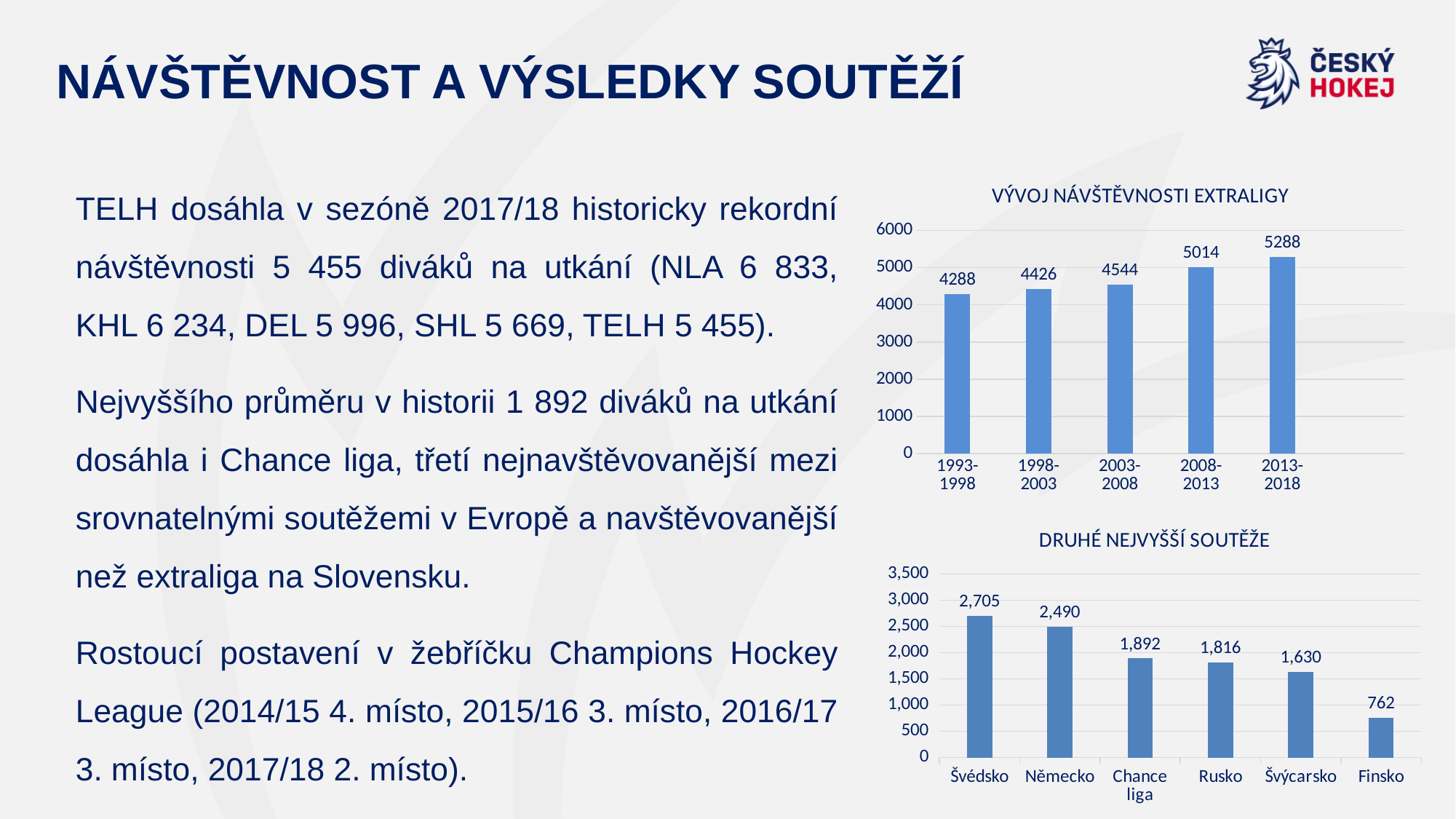
How many periods are shown in the 'VÝVOJ NÁVŠTĚVNOSTI EXTRALIGY' chart? 5 How many categories are shown in the 'DRUHÉ NEJVYŠŠÍ SOUTĚŽE' chart? 6 In the 'VÝVOJ NÁVŠTĚVNOSTI EXTRALIGY' chart, which period has the highest value? 2013-2018 In the 'DRUHÉ NEJVYŠŠÍ SOUTĚŽE' chart, which is larger, Švédsko or Německo? Švédsko In the 'DRUHÉ NEJVYŠŠÍ SOUTĚŽE' chart, what is the difference between the values for Švédsko and Finsko? 1,943 In the 'VÝVOJ NÁVŠTĚVNOSTI EXTRALIGY' chart, which period has the lowest value? 1993-1998 In the 'VÝVOJ NÁVŠTĚVNOSTI EXTRALIGY' chart, do the values rise or fall from 1993-1998 to 2013-2018? rise In the 'DRUHÉ NEJVYŠŠÍ SOUTĚŽE' chart, what is the value for Chance liga? 1,892 In the 'VÝVOJ NÁVŠTĚVNOSTI EXTRALIGY' chart, what is the difference between the values for 2013-2018 and 1993-1998? 1000 What kind of chart is 'DRUHÉ NEJVYŠŠÍ SOUTĚŽE'? bar chart In the 'DRUHÉ NEJVYŠŠÍ SOUTĚŽE' chart, which category has the lowest value? Finsko In the 'VÝVOJ NÁVŠTĚVNOSTI EXTRALIGY' chart, what is the value for 2003-2008? 4544